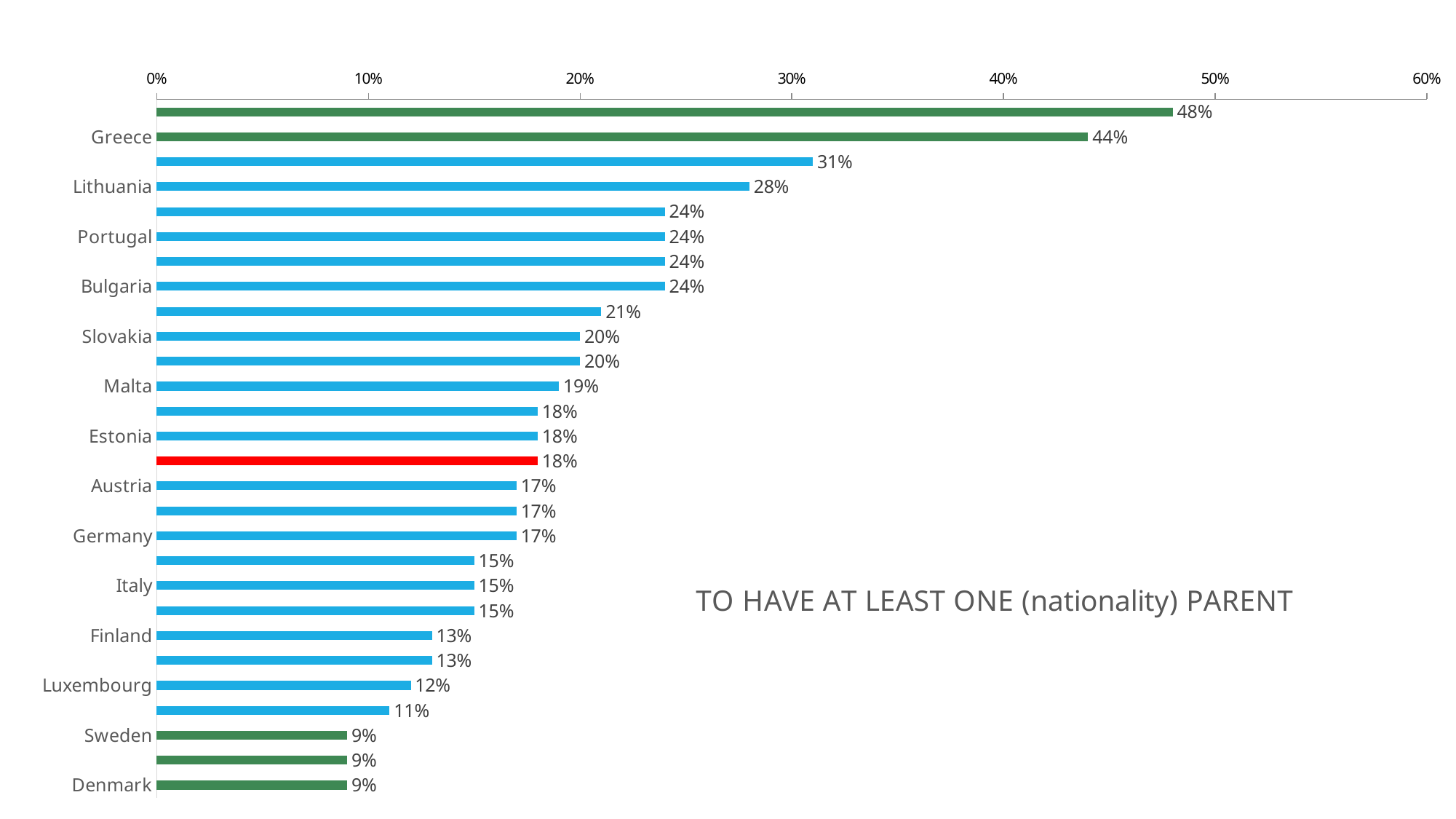
What kind of chart is shown on the slide? Bar chart What is the title text shown on the slide? TO HAVE AT LEAST ONE (nationality) PARENT Is the value for Luxembourg greater or less than 20%? less What is the difference between the values for Greece and Lithuania? 16 percentage points What is the value labelled on the red bar? 18% How many bars are plotted in the chart? 28 What is the value shown for Greece? 44% What is the difference between the values for Austria and Sweden? 8 percentage points What is the value shown for Lithuania? 28% Which has a larger value, Portugal or Slovakia? Portugal What is the value shown for Denmark? 9% What is the value labelled on the longest bar in the chart? 48%